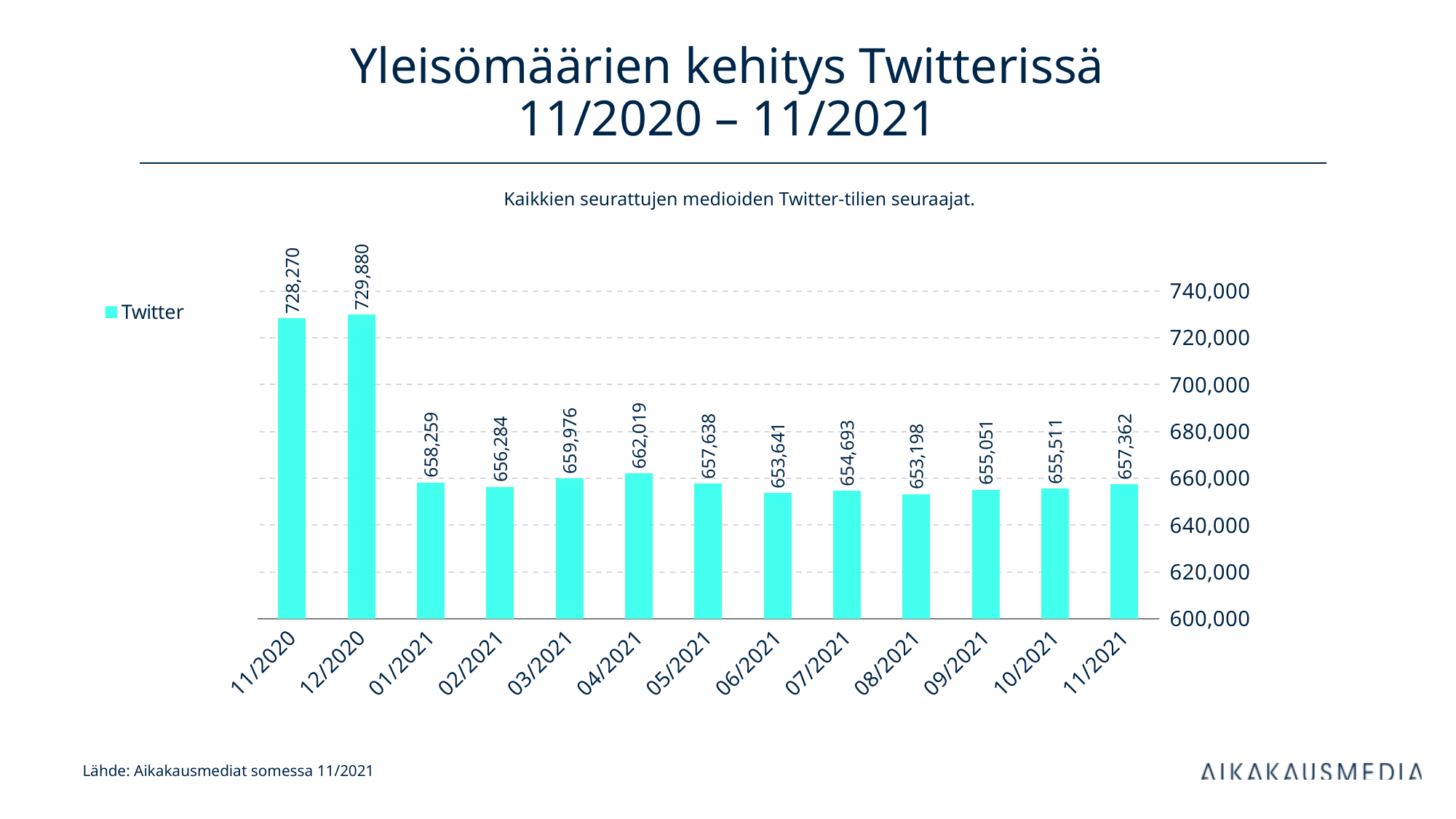
What is the value for 04/2021? 662,019 What is the value for 11/2020? 728,270 Which month has the lowest value? 08/2021 How many series does the legend list? 1 What kind of chart is shown? bar chart Which month has the highest value? 12/2020 Is the value for 02/2021 greater or less than 700,000? less What is the value for 11/2021? 657,362 What is the difference between the values for 11/2020 and 11/2021? 70,908 Which is larger, the value for 03/2021 or the value for 06/2021? 03/2021 How many months are shown on the x axis? 13 What is the difference between the values for 12/2020 and 01/2021? 71,621